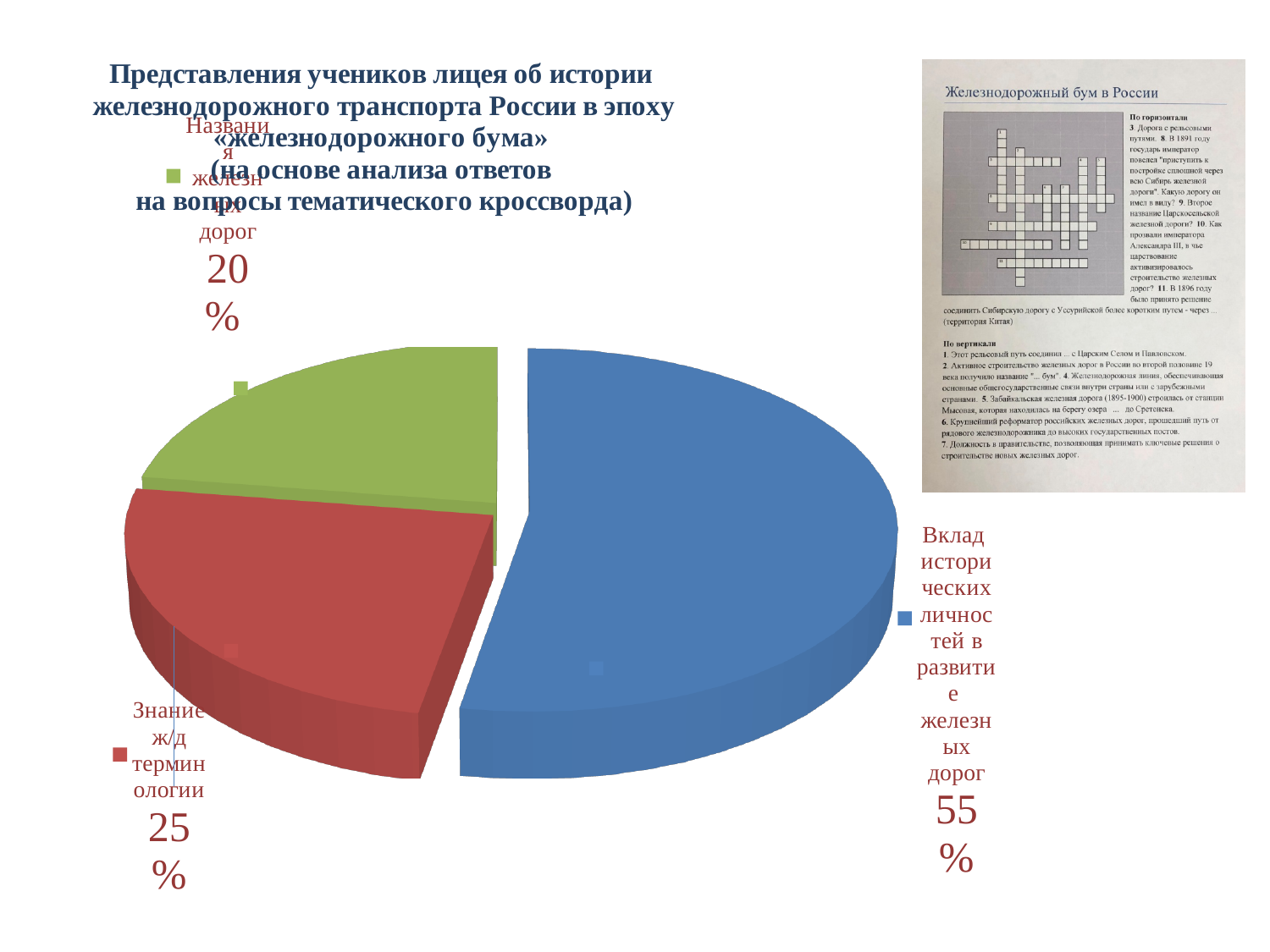
What kind of chart is shown on the slide? pie chart Which category has the largest share of the pie? Вклад исторических личностей в развитие железных дорог What is the combined share of "Знание ж/д терминологии" and "Названия железных дорог"? 45% How many slices does the pie chart have? 3 What colour is the slice for "Названия железных дорог"? green What percentage is shown for "Вклад исторических личностей в развитие железных дорог"? 55% What percentage is shown for "Знание ж/д терминологии"? 25% Which is larger: the share for "Знание ж/д терминологии" or the share for "Названия железных дорог"? Знание ж/д терминологии What percentage is shown for "Названия железных дорог"? 20% What colour is the slice for "Вклад исторических личностей в развитие железных дорог"? blue Which category has the smallest share of the pie? Названия железных дорог What is the difference in percentage points between "Вклад исторических личностей в развитие железных дорог" and "Знание ж/д терминологии"? 30